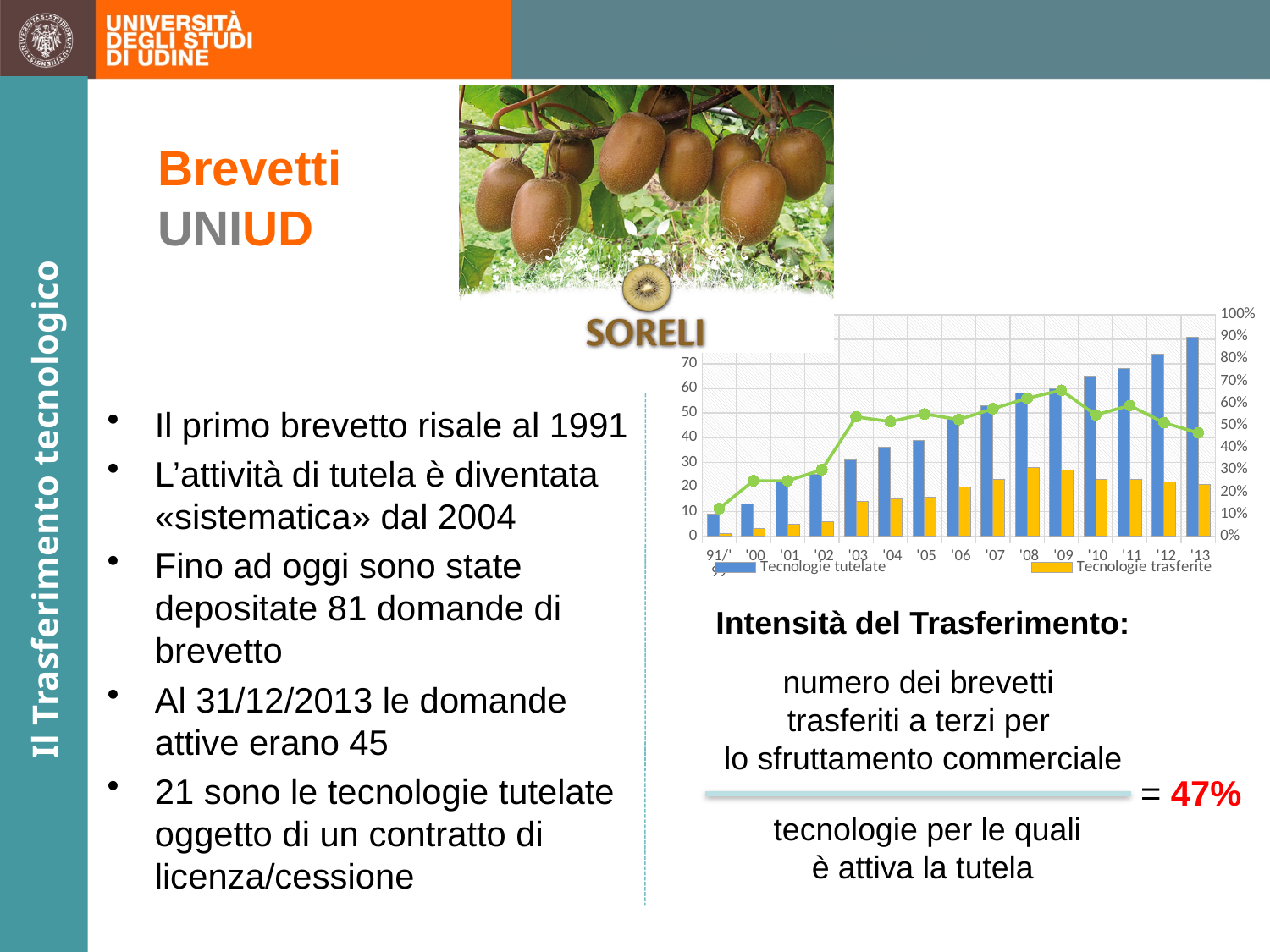
What kind of chart is shown on the slide? bar chart with a line Is the Tecnologie trasferite value for '00 greater or less than 10? less Which is larger: the Tecnologie tutelate bar for '13 or for '00? '13 Is the Tecnologie tutelate value for '13 greater or less than 60? greater What are the two series named in the chart legend? Tecnologie tutelate, Tecnologie trasferite Is the Tecnologie tutelate value for '03 greater or less than 20? greater Do the Tecnologie tutelate bars generally rise or fall from 91/'99 to '13? rise How many year categories are shown on the x axis of the chart? 15 In which year is the Tecnologie tutelate bar the highest? '13 In which category is the Tecnologie trasferite bar the lowest? 91/'99 In which category is the Tecnologie tutelate bar the lowest? 91/'99 How many series does the chart legend list? 2